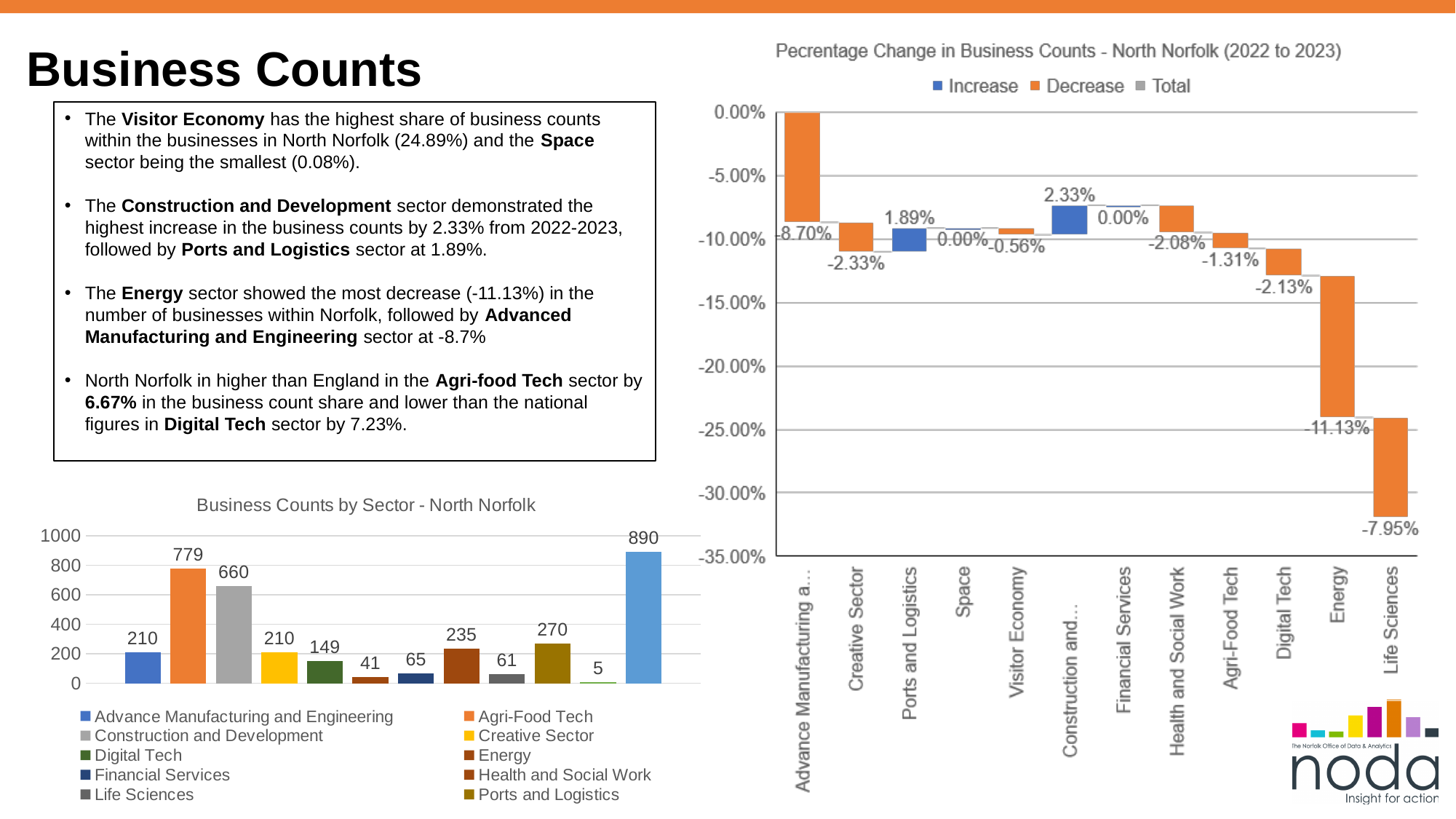
In the 'Percentage Change in Business Counts - North Norfolk (2022 to 2023)' chart, what is the value for Energy? -11.13% How many series does the legend of the 'Percentage Change in Business Counts - North Norfolk (2022 to 2023)' chart list? 3 In the 'Business Counts by Sector - North Norfolk' chart, what is the business count for Construction and Development? 660 In the 'Business Counts by Sector - North Norfolk' chart, what is the highest value shown on any bar? 890 How many bars are plotted in the 'Business Counts by Sector - North Norfolk' chart? 12 In the 'Percentage Change in Business Counts - North Norfolk (2022 to 2023)' chart, what is the value for Ports and Logistics? 1.89% In the 'Business Counts by Sector - North Norfolk' chart, which has the larger count: Ports and Logistics or Health and Social Work? Ports and Logistics In the 'Business Counts by Sector - North Norfolk' chart, what is the lowest value shown on any bar? 5 In the 'Business Counts by Sector - North Norfolk' chart, what is the difference between the Agri-Food Tech and Construction and Development counts? 119 In the 'Business Counts by Sector - North Norfolk' chart, what is the business count for Health and Social Work? 235 What kind of chart is 'Business Counts by Sector - North Norfolk'? Bar chart In the 'Business Counts by Sector - North Norfolk' chart, what is the business count for Agri-Food Tech? 779